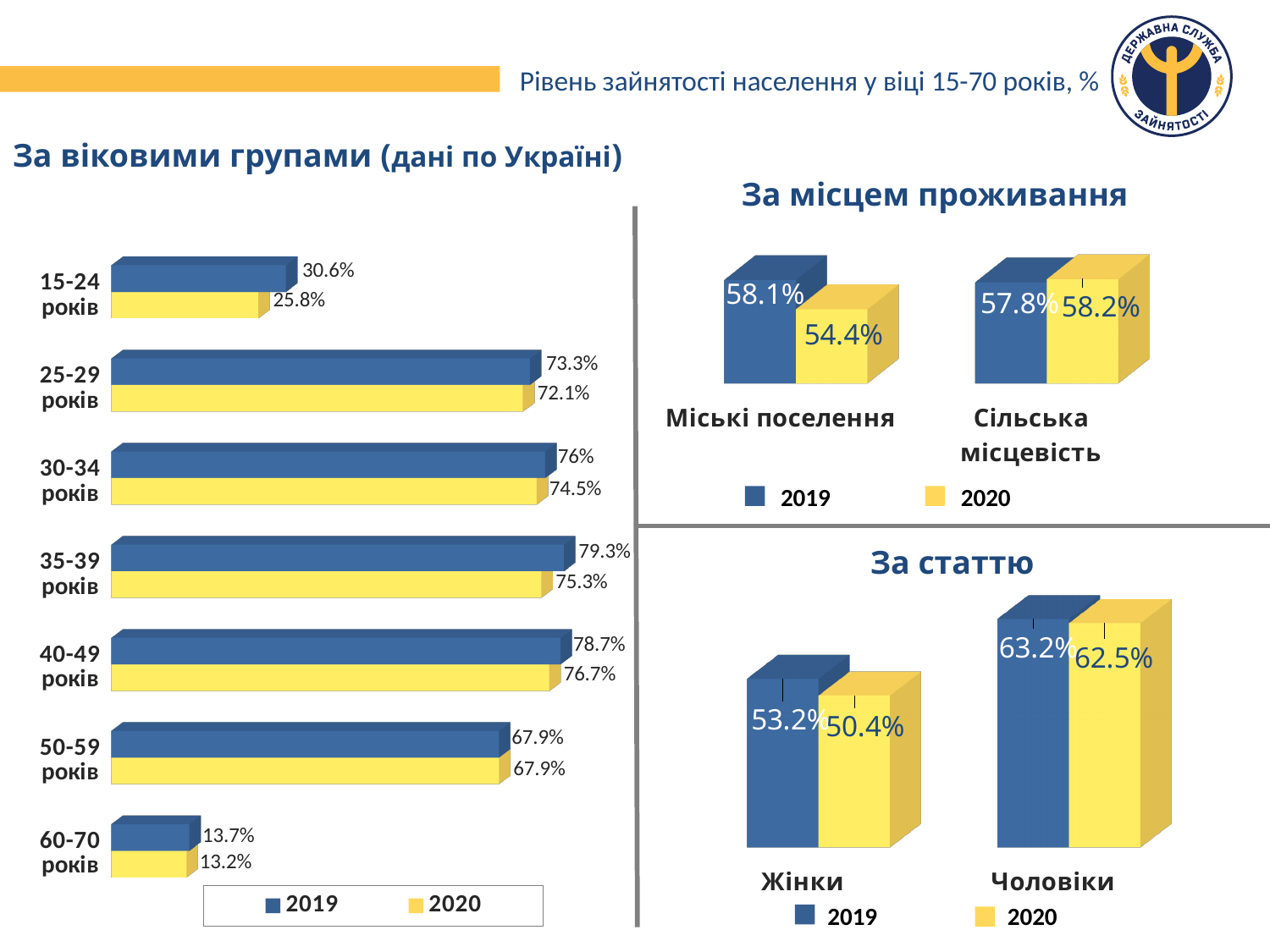
In the 'За віковими групами' chart, which age group has the highest 2019 value? 35-39 років In the 'За місцем проживання' chart, which is larger for Сільська місцевість: the 2019 value or the 2020 value? 2020 In the 'За віковими групами' chart, how many age groups are shown? 7 In the 'За віковими групами' chart, which age group has the lowest 2020 value? 60-70 років In the 'За місцем проживання' chart, what is the 2020 value for Міські поселення? 54.4% In the 'За статтю' chart, what is the difference between the 2019 and 2020 values for Жінки? 2.8% In the 'За віковими групами' chart, what type of chart is used? Bar chart In the 'За віковими групами' chart, what is the difference between the 2019 and 2020 values for the 15-24 років group? 4.8% In the 'За віковими групами' chart, what is the 2019 value for the 35-39 років group? 79.3% In the 'За віковими групами' chart, what is the 2020 value for the 15-24 років group? 25.8% How many series does the legend of the 'За статтю' chart list? 2 In the 'За статтю' chart, what is the 2019 value for Чоловіки? 63.2%